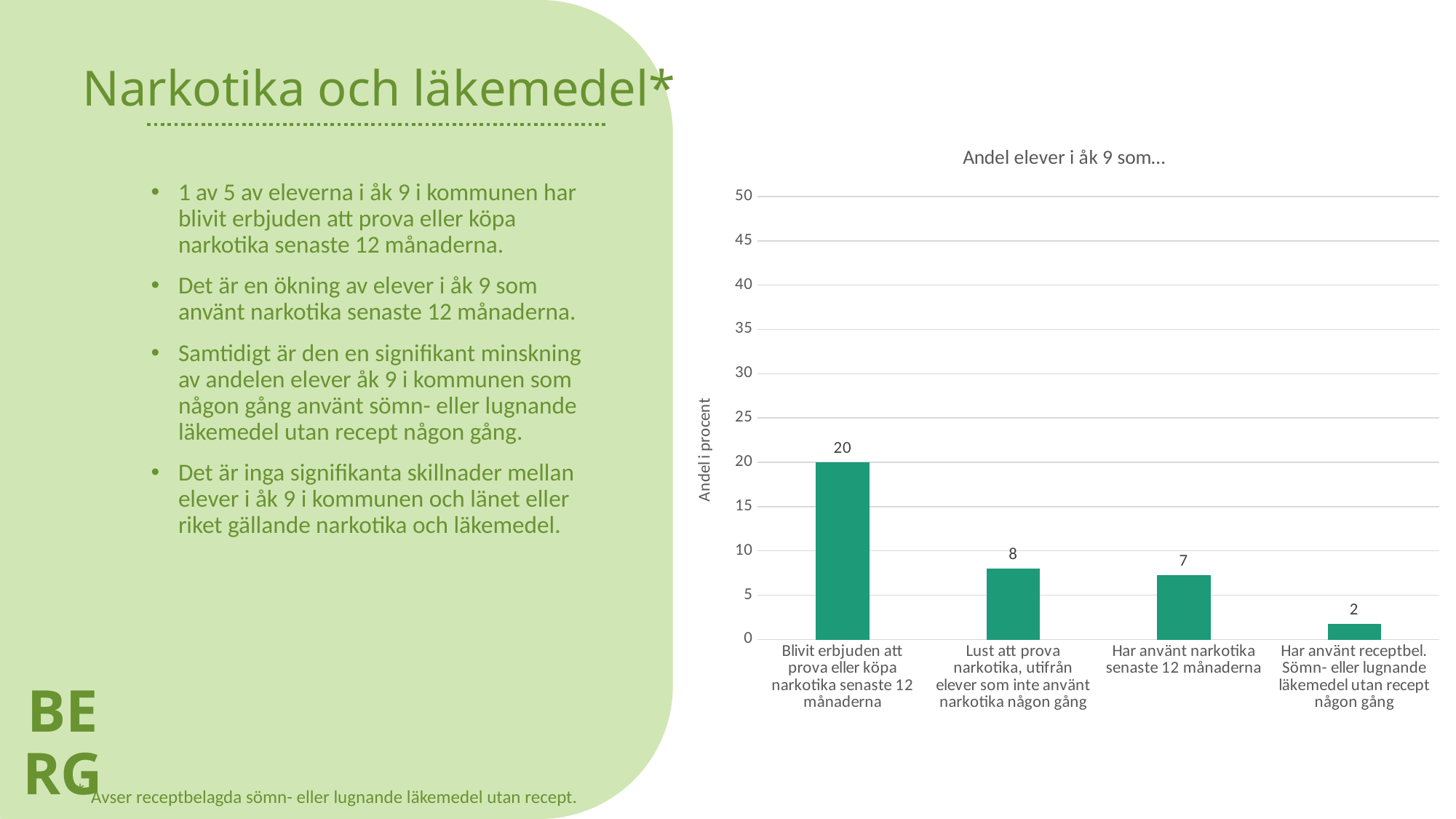
What is the value for 'Blivit erbjuden att prova eller köpa narkotika senaste 12 månaderna'? 20 What is the value for 'Lust att prova narkotika, utifrån elever som inte använt narkotika någon gång'? 8 What is the value for 'Har använt receptbel. Sömn- eller lugnande läkemedel utan recept någon gång'? 2 Which is larger: the value for 'Lust att prova narkotika, utifrån elever som inte använt narkotika någon gång' or the value for 'Har använt receptbel. Sömn- eller lugnande läkemedel utan recept någon gång'? Lust att prova narkotika, utifrån elever som inte använt narkotika någon gång What is the title of the chart? Andel elever i åk 9 som… What kind of chart is shown on the slide? Bar chart How many categories are shown in the chart? 4 Is the value for 'Blivit erbjuden att prova eller köpa narkotika senaste 12 månaderna' greater or less than 15? greater Which category has the highest value? Blivit erbjuden att prova eller köpa narkotika senaste 12 månaderna What is the value for 'Har använt narkotika senaste 12 månaderna'? 7 Which category has the lowest value? Har använt receptbel. Sömn- eller lugnande läkemedel utan recept någon gång What is the difference between the value for 'Blivit erbjuden att prova eller köpa narkotika senaste 12 månaderna' and the value for 'Har använt narkotika senaste 12 månaderna'? 13